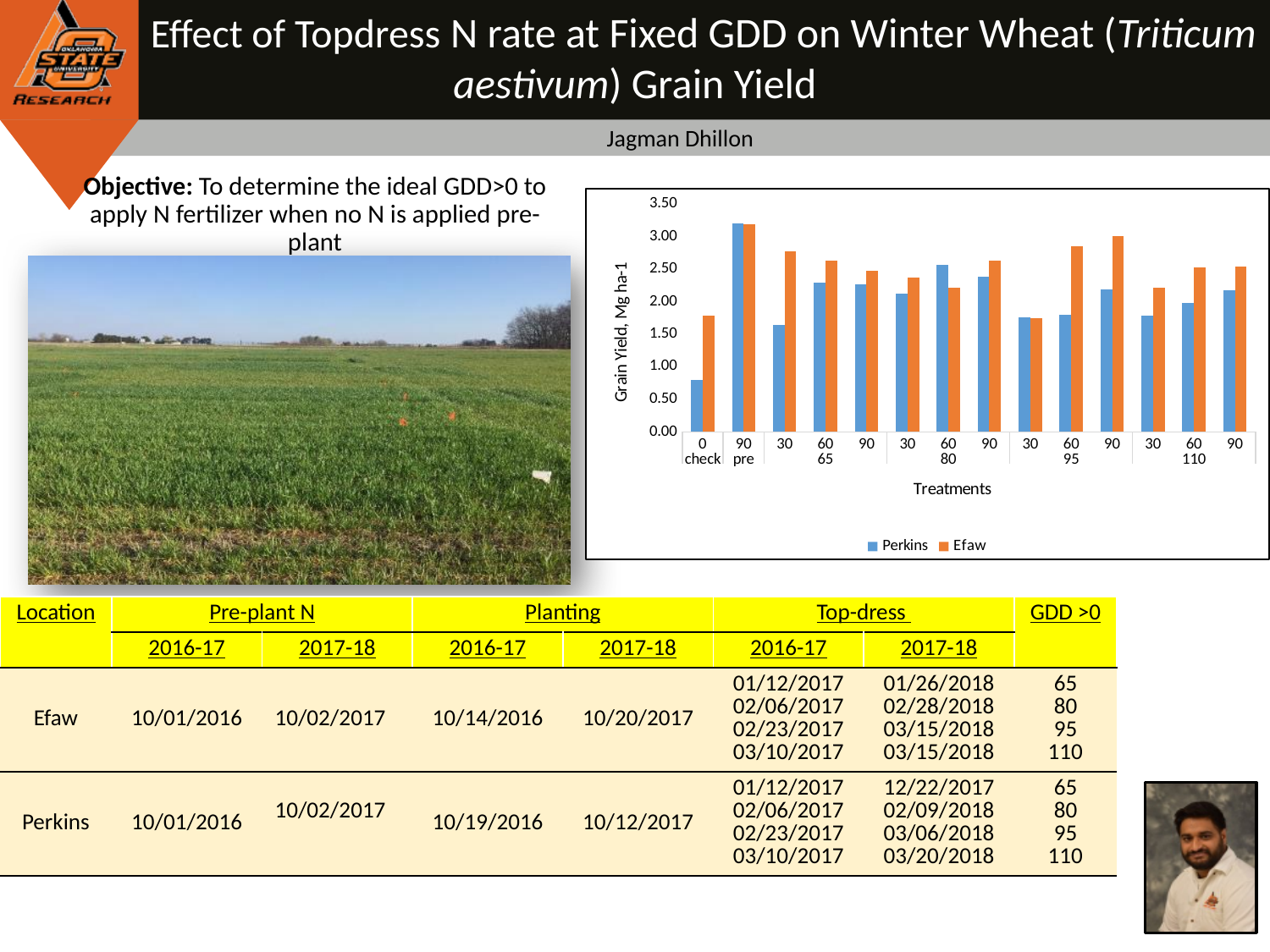
Which treatment has the highest Efaw grain yield? 90 pre Is the Perkins grain yield for the 90 pre treatment greater or less than 3.00? greater Is the Efaw grain yield for the 30 treatment at GDD 65 greater or less than 2.50? greater How many treatment categories are plotted along the x axis of the chart? 14 How many series does the chart legend list? 2 Is the Perkins grain yield for the 0 check treatment greater or less than 1.00? less What kind of chart is shown on the slide? bar chart Which treatment has the lowest Perkins grain yield? 0 check For the 60 treatment at GDD 80, which location has the higher grain yield, Perkins or Efaw? Perkins For the 0 check treatment, which location has the higher grain yield, Perkins or Efaw? Efaw Which treatment has the highest Perkins grain yield? 90 pre What is the title of the chart's y axis? Grain Yield, Mg ha-1